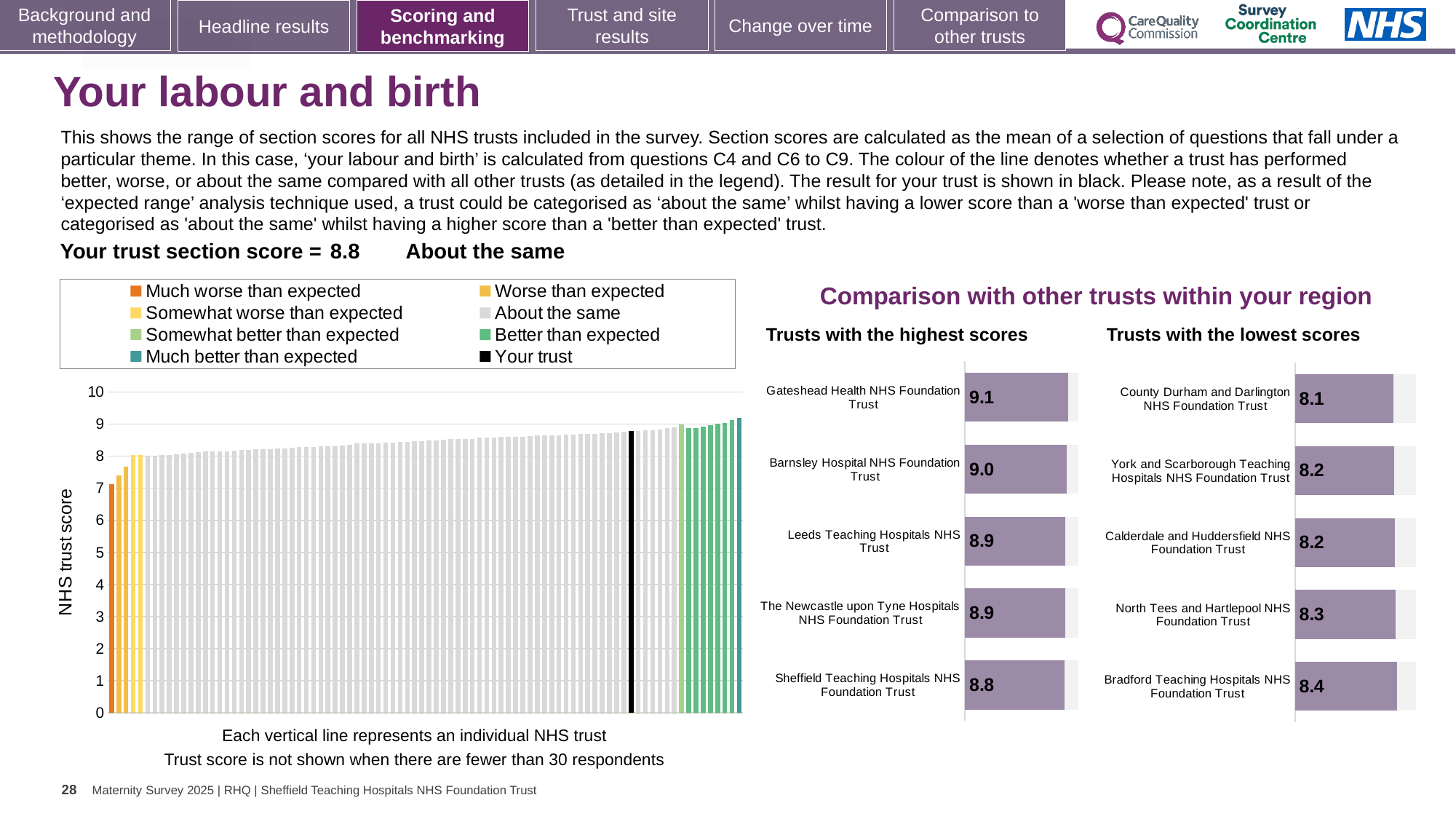
In the 'Trusts with the highest scores' chart, what is the difference between the scores of Gateshead Health NHS Foundation Trust and Sheffield Teaching Hospitals NHS Foundation Trust? 0.3 In the 'Trusts with the highest scores' chart, how many trusts are shown? 5 In the main chart on the left showing all NHS trusts, what kind of chart is it? Bar chart In the main chart on the left showing all NHS trusts, how many entries does the legend list? 8 In the 'Trusts with the lowest scores' chart, which has the larger score: North Tees and Hartlepool NHS Foundation Trust or County Durham and Darlington NHS Foundation Trust? North Tees and Hartlepool NHS Foundation Trust In the 'Trusts with the highest scores' chart, what is the score for Gateshead Health NHS Foundation Trust? 9.1 In the 'Trusts with the highest scores' chart, which trust has the highest score? Gateshead Health NHS Foundation Trust In the 'Trusts with the lowest scores' chart, which trust has the lowest score? County Durham and Darlington NHS Foundation Trust In the 'Trusts with the lowest scores' chart, what is the score for Bradford Teaching Hospitals NHS Foundation Trust? 8.4 In the main chart on the left showing all NHS trusts, do the bar values rise or fall from left to right? Rise In the main chart on the left showing all NHS trusts, is the value of the leftmost (orange) bar greater or less than 8? less In the 'Trusts with the lowest scores' chart, what is the score for York and Scarborough Teaching Hospitals NHS Foundation Trust? 8.2